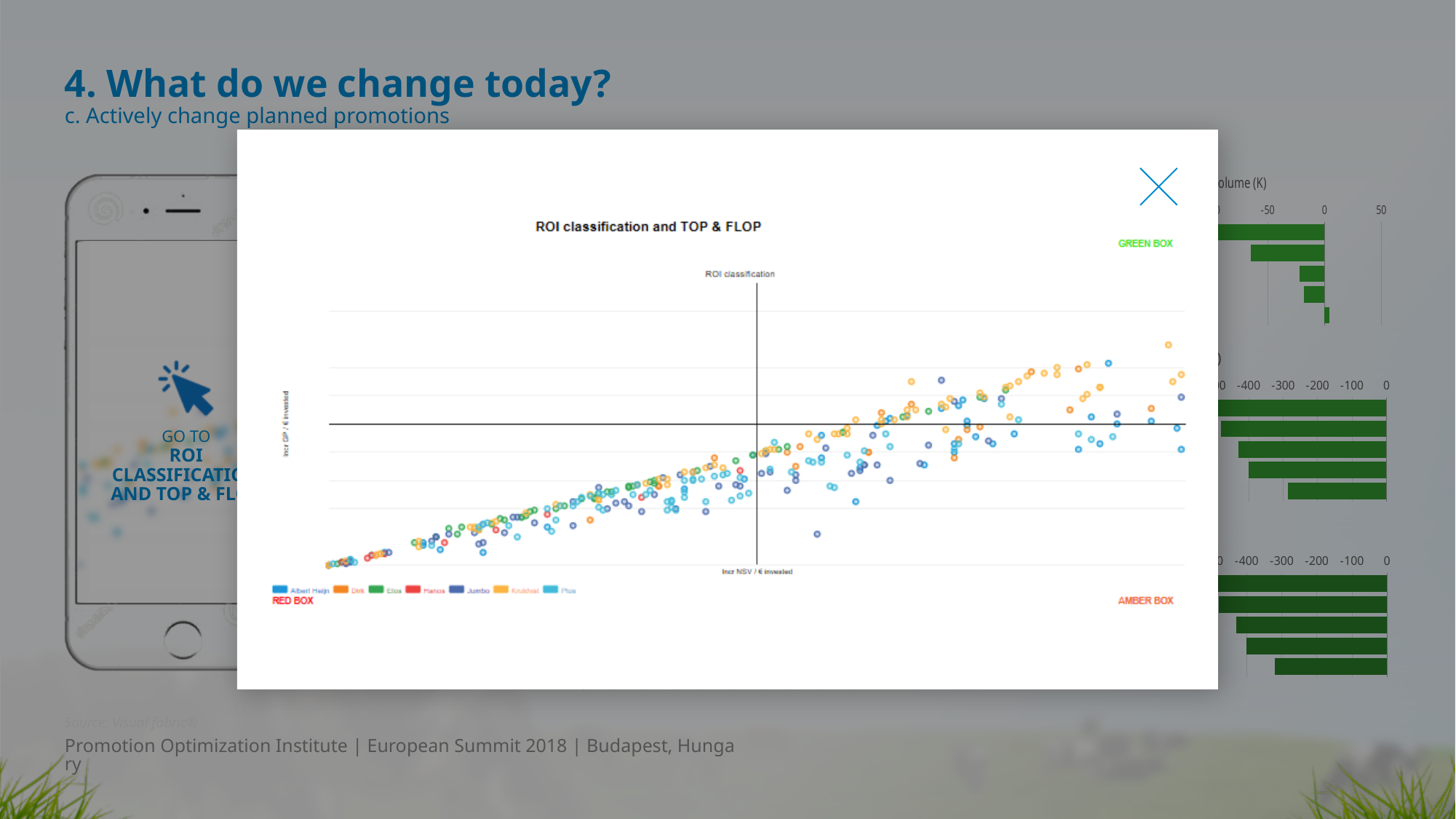
What is the title of the scatter chart shown in the pop-up window? ROI classification and TOP & FLOP In the 'ROI classification and TOP & FLOP' chart, which legend entry is listed last? Plus In the 'ROI classification and TOP & FLOP' chart, which legend entry is listed first? Albert Heijn How many series does the legend of the 'ROI classification and TOP & FLOP' chart list? 7 What kind of chart is 'ROI classification and TOP & FLOP'? scatter chart In the 'ROI classification and TOP & FLOP' chart, do the points generally rise or fall from left to right along the x axis? rise